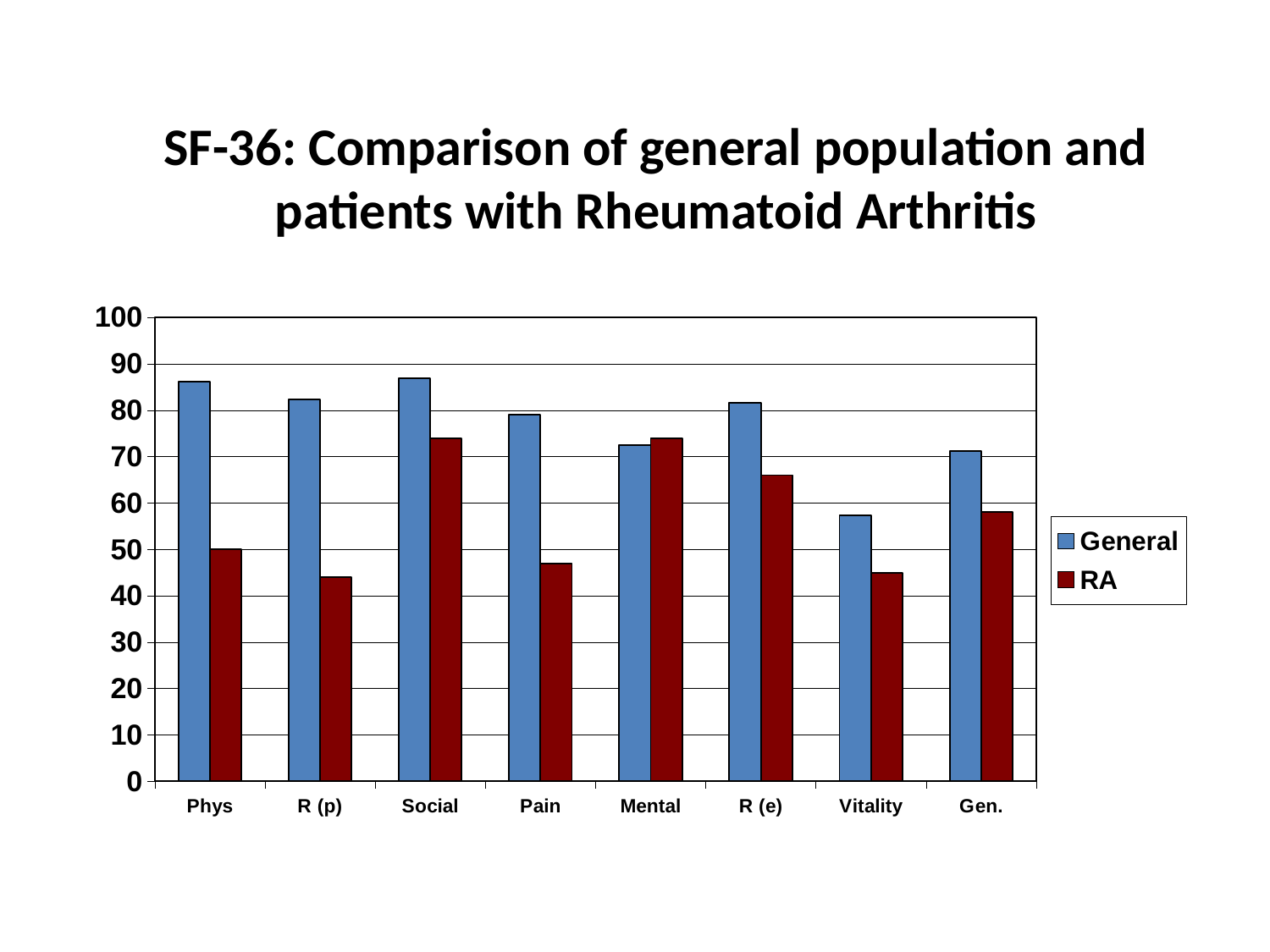
How many series does the legend list? 2 What colour are the bars for the RA series? dark red How many categories are shown on the x axis? 8 Is the RA value for R (e) greater or less than 60? greater For Phys, which series has the larger value, General or RA? General Is the General value for Phys greater or less than 80? greater Is the General value for Vitality greater or less than 60? less What kind of chart is shown on the slide? bar chart For the General series, which is larger, Social or Vitality? Social Which category has the lowest value for the General series? Vitality